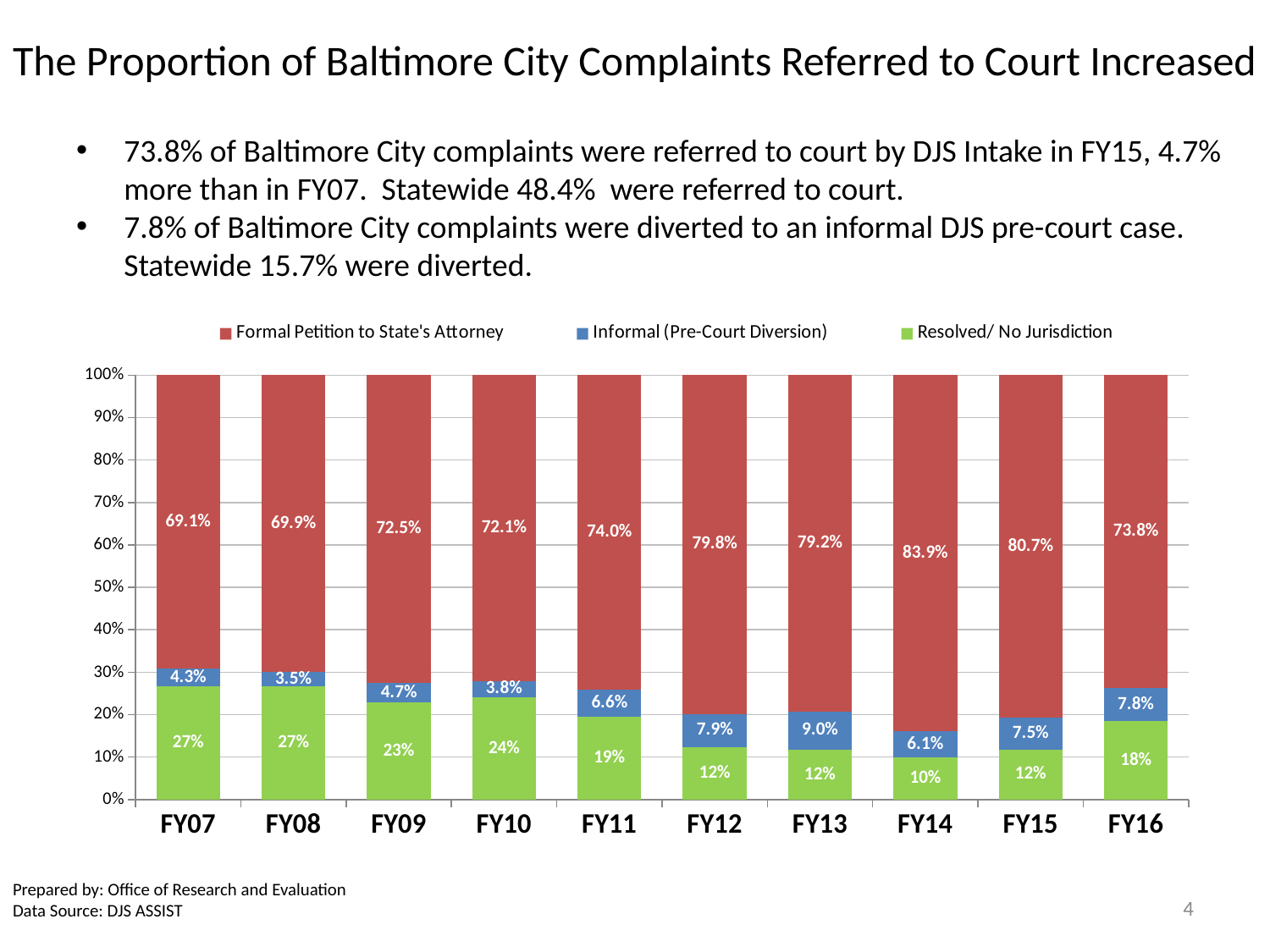
In which fiscal year is the Formal Petition to State's Attorney share highest? FY14 What kind of chart is shown on the slide? Stacked bar chart How many series does the legend list? 3 Does the Resolved/ No Jurisdiction share rise or fall from FY07 to FY14? Fall How many fiscal years are shown on the x axis? 10 What is the Resolved/ No Jurisdiction value for FY16? 18% In which fiscal year is the Informal (Pre-Court Diversion) share highest? FY13 How much higher is the Formal Petition to State's Attorney share in FY16 than in FY07? 4.7% What is the Informal (Pre-Court Diversion) value for FY11? 6.6% Which year has the larger Informal (Pre-Court Diversion) share, FY09 or FY10? FY09 What is the Formal Petition to State's Attorney value for FY14? 83.9% In which fiscal year is the Resolved/ No Jurisdiction share lowest? FY14